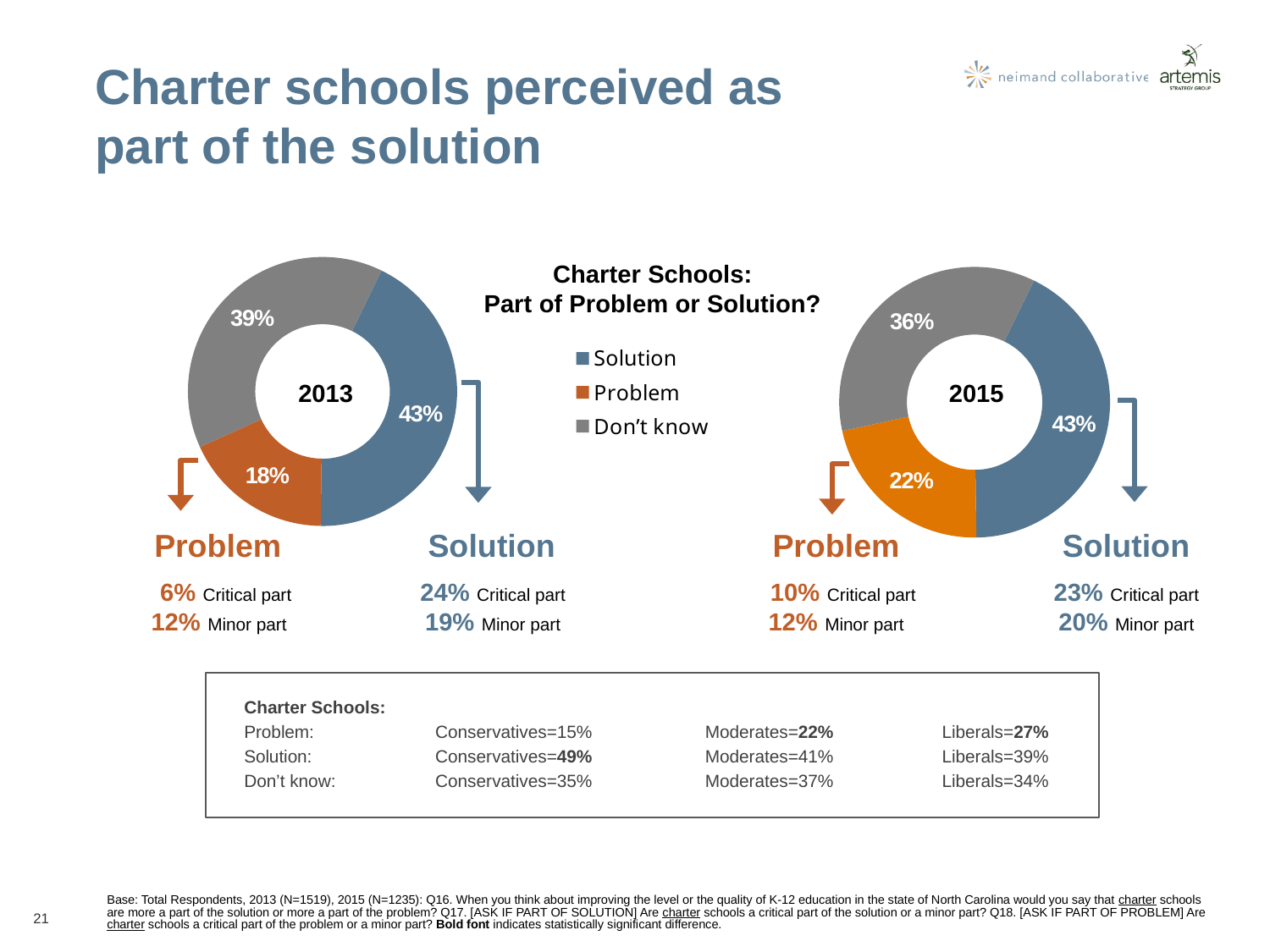
In the 2013 donut chart, which response category has the largest share? Solution In the 2015 donut chart, what percentage answered 'Don't know'? 36% In the 2013 donut chart, what is the difference in percentage points between the 'Don't know' and 'Problem' shares? 21 By how many percentage points did the 'Problem' share increase from the 2013 chart to the 2015 chart? 4 How many series does the shared legend list for the donut charts? 3 Is the 'Don't know' share larger in the 2013 chart or the 2015 chart? 2013 In the 2015 donut chart, what percentage of respondents said charter schools are part of the problem? 22% In the 2013 donut chart, what percentage answered 'Don't know'? 39% What type of chart is used to show the 2013 and 2015 results? Donut (pie) chart What is the title shown between the two donut charts? Charter Schools: Part of Problem or Solution? In the 2015 donut chart, which response category has the smallest share? Problem In the 2013 donut chart, what percentage of respondents said charter schools are part of the solution? 43%